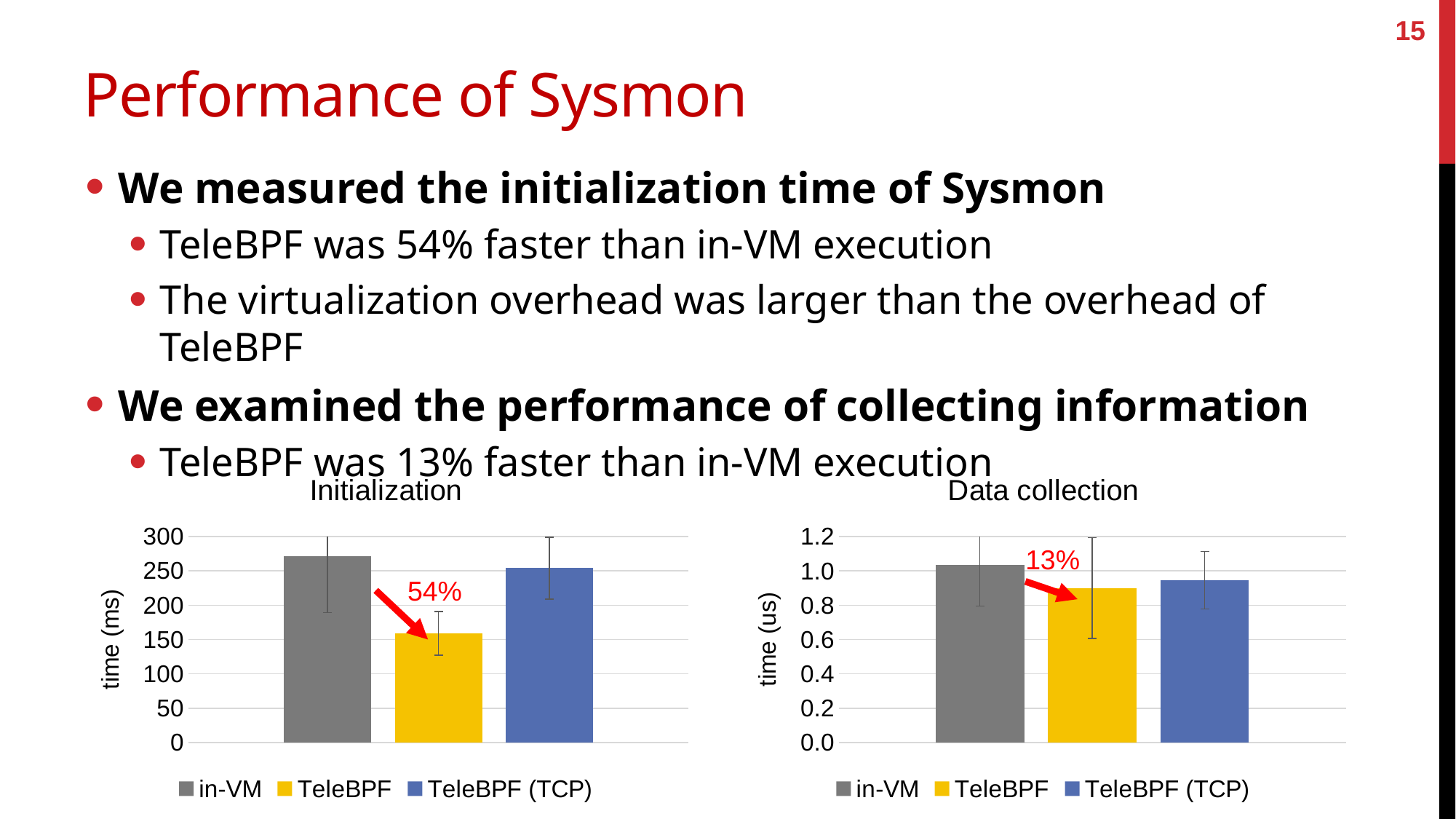
In the Initialization chart, which is larger, the in-VM bar or the TeleBPF bar? in-VM In the Initialization chart, which series has the lowest time? TeleBPF In the Initialization chart, is the value for TeleBPF (TCP) greater or less than 200? greater How many series does the legend of the Data collection chart list? 3 In the Data collection chart, which is larger, the in-VM bar or the TeleBPF bar? in-VM What percentage is annotated in red on the Initialization chart? 54% In the Initialization chart, is the value for TeleBPF greater or less than 200? less What kind of chart is the Initialization chart? bar chart In the Data collection chart, is the value for TeleBPF greater or less than 1.0? less How many bars are plotted in the Initialization chart? 3 What is the y-axis label of the Data collection chart? time (us)